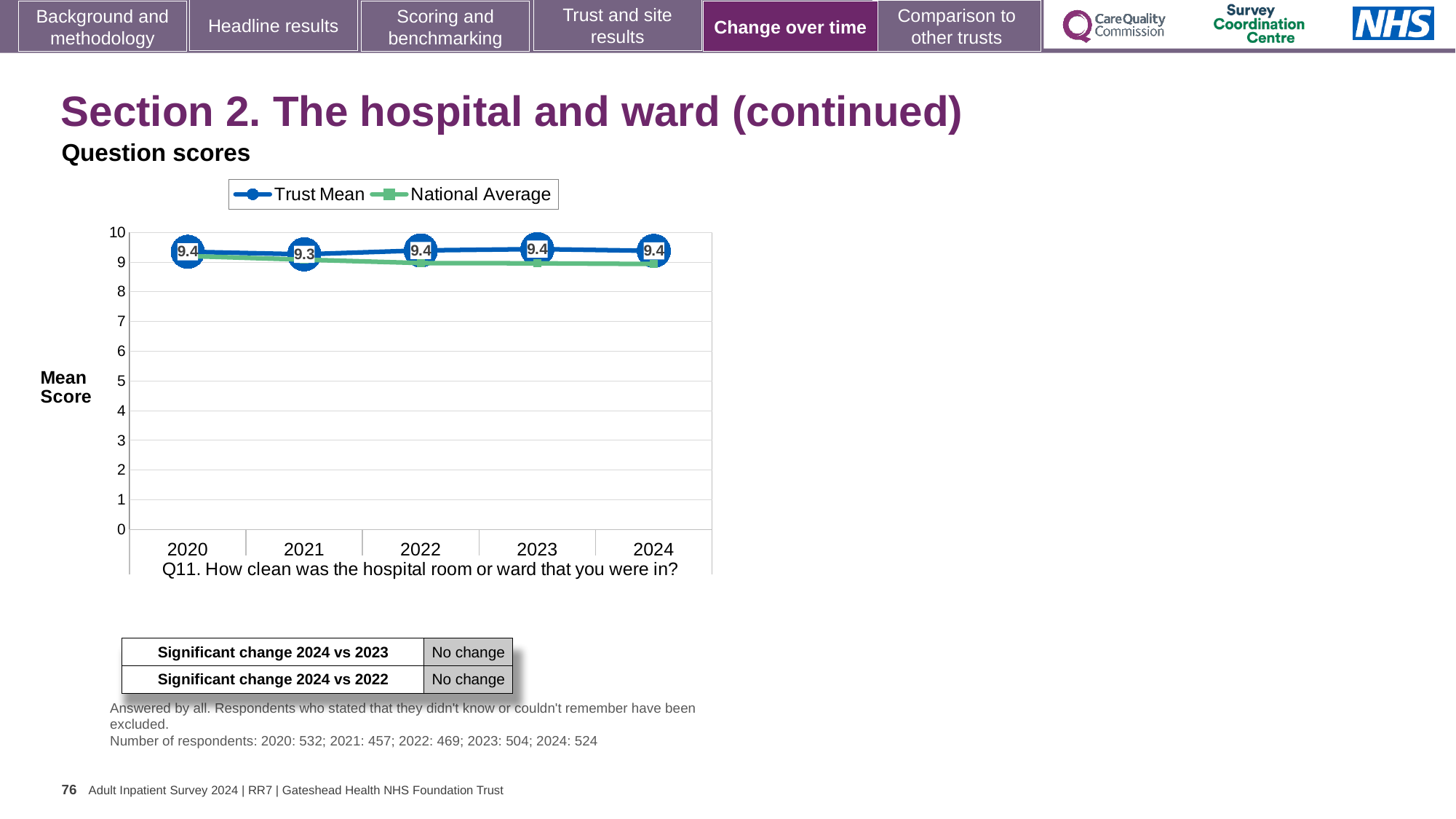
What is the Trust Mean value for 2020? 9.4 What is the Trust Mean value for 2024? 9.4 In which year is the Trust Mean lowest? 2021 In 2024, which series has the higher value, Trust Mean or National Average? Trust Mean How many years are shown on the x axis? 5 What is the Trust Mean value for 2021? 9.3 What kind of chart is shown on the slide? Line chart What is the label of the y axis? Mean Score Is the National Average value for 2024 greater or less than 8? greater Which survey question does the chart show scores for? Q11. How clean was the hospital room or ward that you were in? How many series does the legend list? 2 What is the difference between the Trust Mean in 2020 and in 2021? 0.1